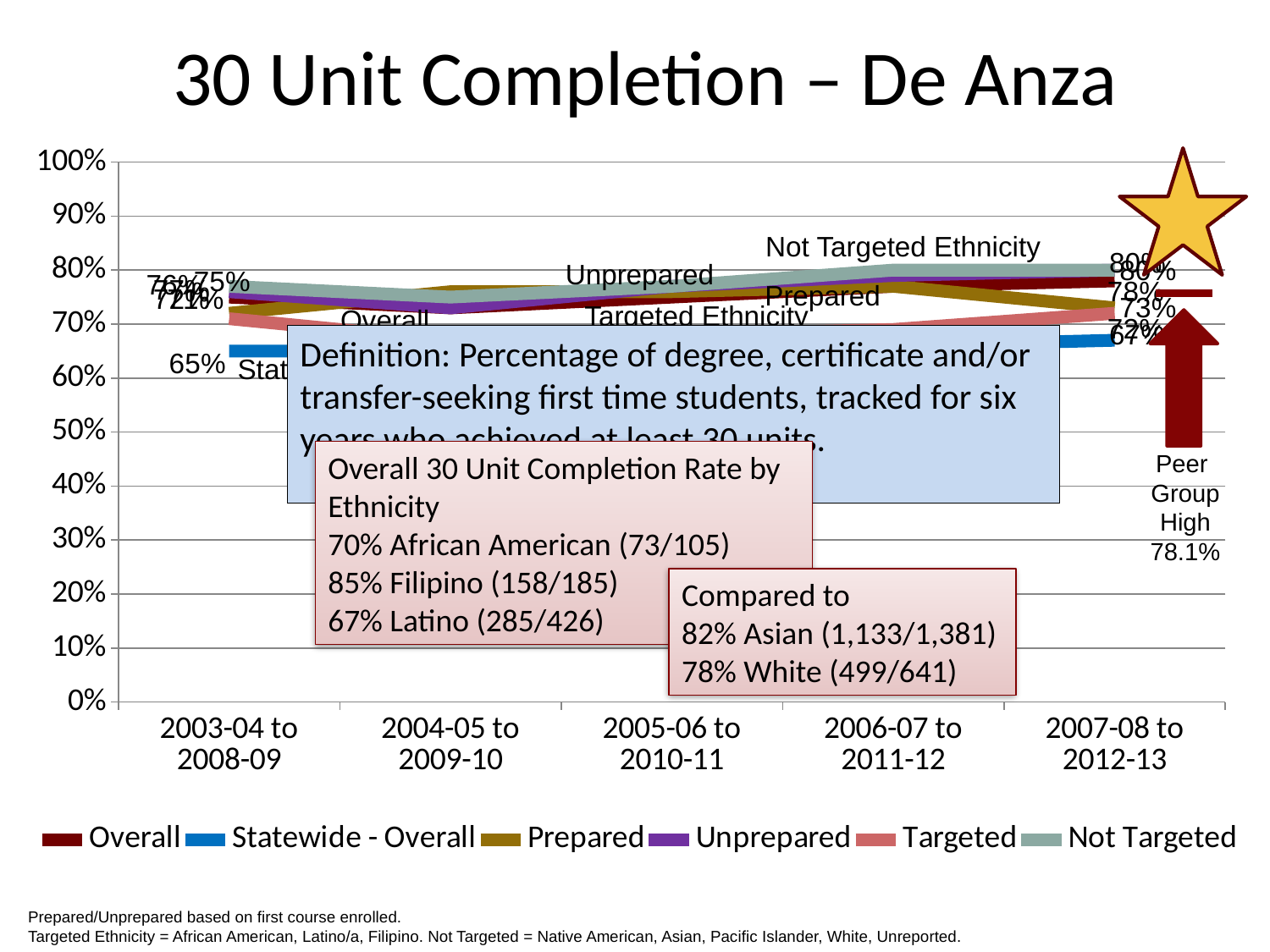
For 2007-08 to 2012-13, which is larger: Not Targeted or Statewide - Overall? Not Targeted What is the Statewide - Overall value for 2003-04 to 2008-09? 65% How many series does the legend list? 6 Is the Not Targeted value for 2007-08 to 2012-13 greater or less than 70%? greater Which series has the lowest value in 2003-04 to 2008-09? Statewide - Overall Which series is shown in blue in the legend? Statewide - Overall What kind of chart is shown on the slide? Line chart Is the Statewide - Overall value for 2003-04 to 2008-09 greater or less than 70%? less How many time periods are shown along the x axis? 5 Is the Statewide - Overall value for 2007-08 to 2012-13 greater or less than 70%? less What is the last x-axis period shown on the chart? 2007-08 to 2012-13 What is the title of the chart? 30 Unit Completion – De Anza